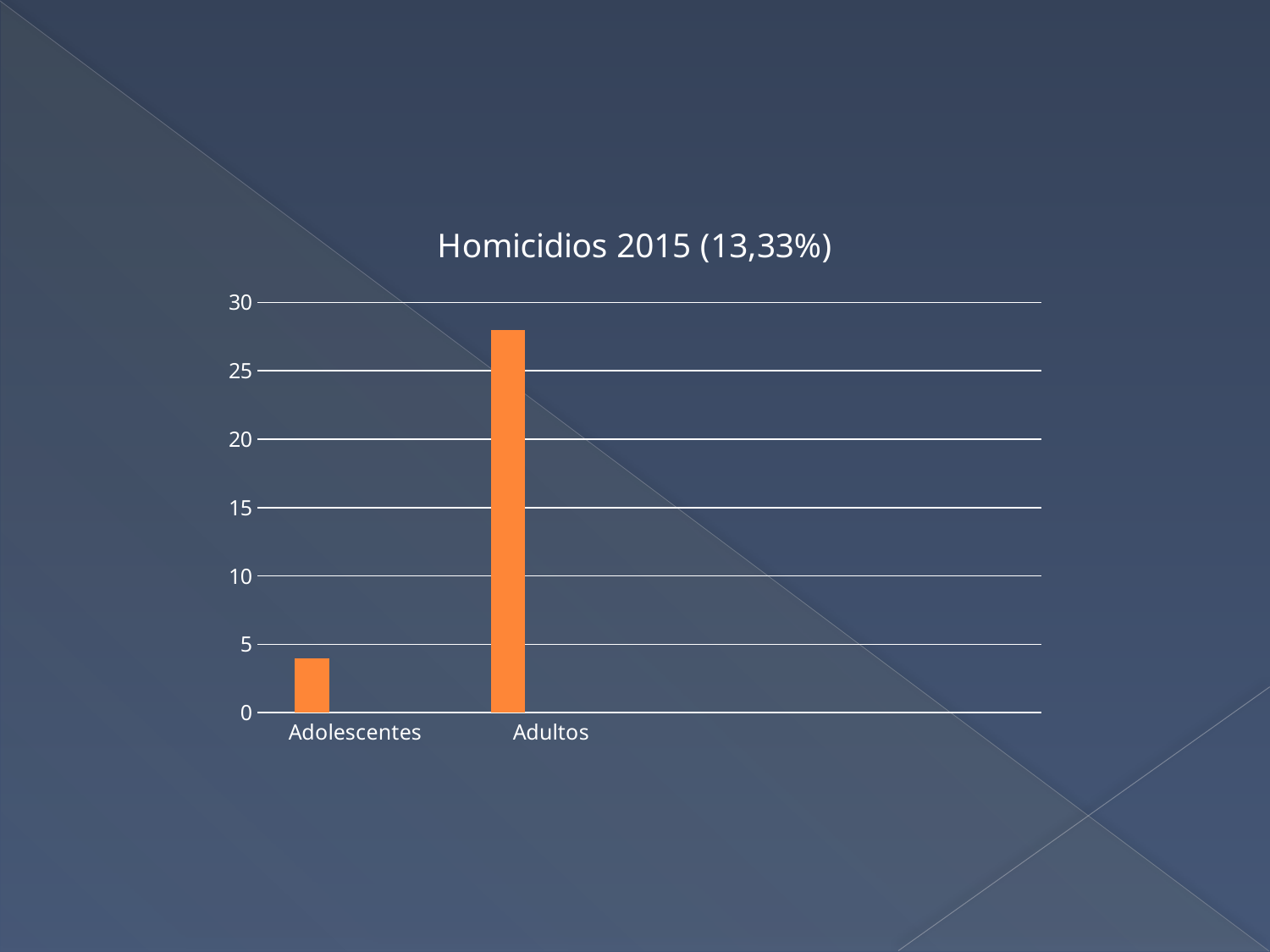
What colour are the bars in the chart? orange How many categories are shown on the x axis of the chart? 2 Is the value for Adolescentes greater or less than 5? less Do the values rise or fall from Adolescentes to Adultos along the x axis? rise Is the value for Adultos greater or less than 25? greater Is the value for Adolescentes greater or less than 10? less Which is larger, the value for Adolescentes or the value for Adultos? Adultos Which category has the lowest value in the chart? Adolescentes What is the title of the chart? Homicidios 2015 (13,33%) Which category has the highest value in the chart? Adultos What kind of chart is shown on the slide? bar chart